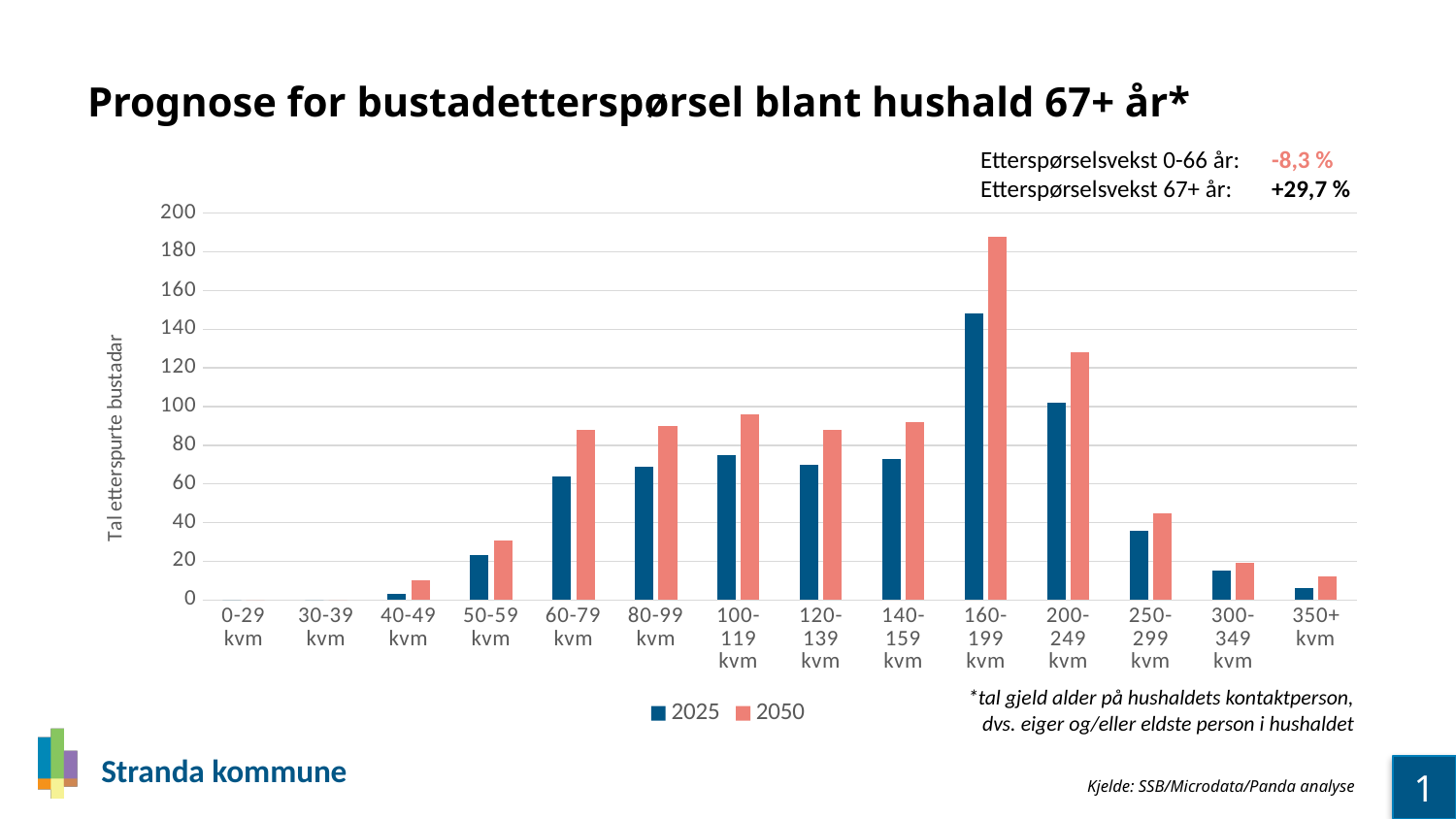
For the 2025 series, which is larger: 160-199 kvm or 200-249 kvm? 160-199 kvm Is the 2025 value for 160-199 kvm greater or less than 140? greater Is the 2050 value for 100-119 kvm greater or less than 100? less For 60-79 kvm, which series has the larger value, 2025 or 2050? 2050 What is the label on the y axis of the chart? Tal etterspurte bustadar Which size category has the highest value for the 2050 series? 160-199 kvm How many size categories are shown on the x axis? 14 Which size category has the highest value for the 2025 series? 160-199 kvm What kind of chart is shown on the slide? bar chart Is the 2050 value for 160-199 kvm greater or less than 180? greater How many series does the legend list? 2